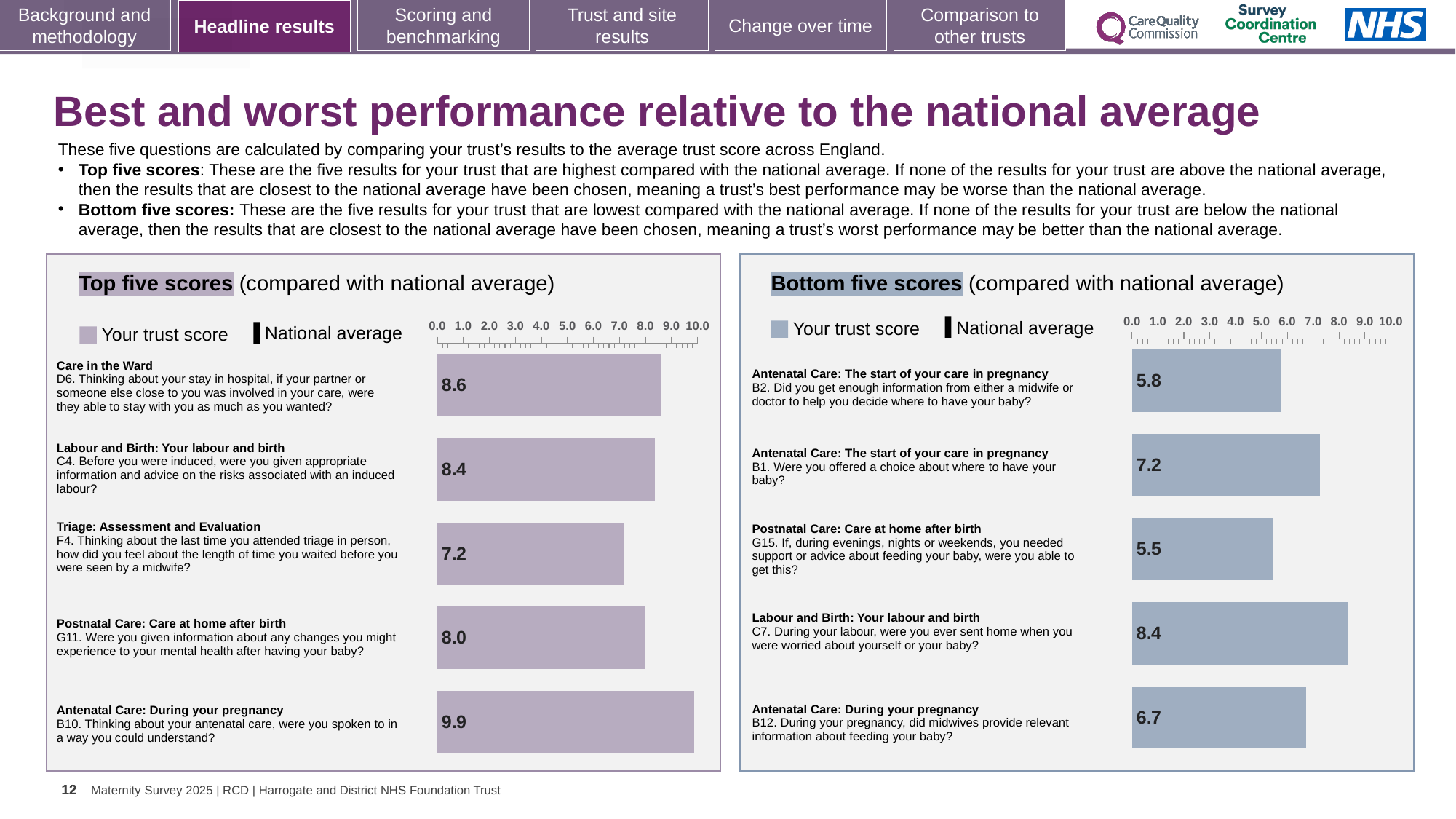
In the Bottom five scores chart, which has the larger trust score: B1 or B12? B1 How many series does the legend of the Top five scores chart list? 2 In the Bottom five scores chart, what is the difference between the trust scores for C7 and B2? 2.6 In the Top five scores chart, what is the difference between the trust scores for B10 and F4? 2.7 How many bars are plotted in the Top five scores chart? 5 In the Bottom five scores chart, what is the trust score for question C7 (Labour and Birth: Your labour and birth)? 8.4 In the Bottom five scores chart, which question has the lowest trust score? G15 (Postnatal Care: Care at home after birth) In the Bottom five scores chart, what is the trust score for question G15 (Postnatal Care: Care at home after birth)? 5.5 What type of chart is the Bottom five scores chart? Bar chart In the Top five scores chart, what is the trust score for question F4 (Triage: Assessment and Evaluation)? 7.2 In the Top five scores chart, which question has the highest trust score? B10 (Antenatal Care: During your pregnancy) In the Top five scores chart, what is the trust score for question B10 (Antenatal Care: During your pregnancy)? 9.9